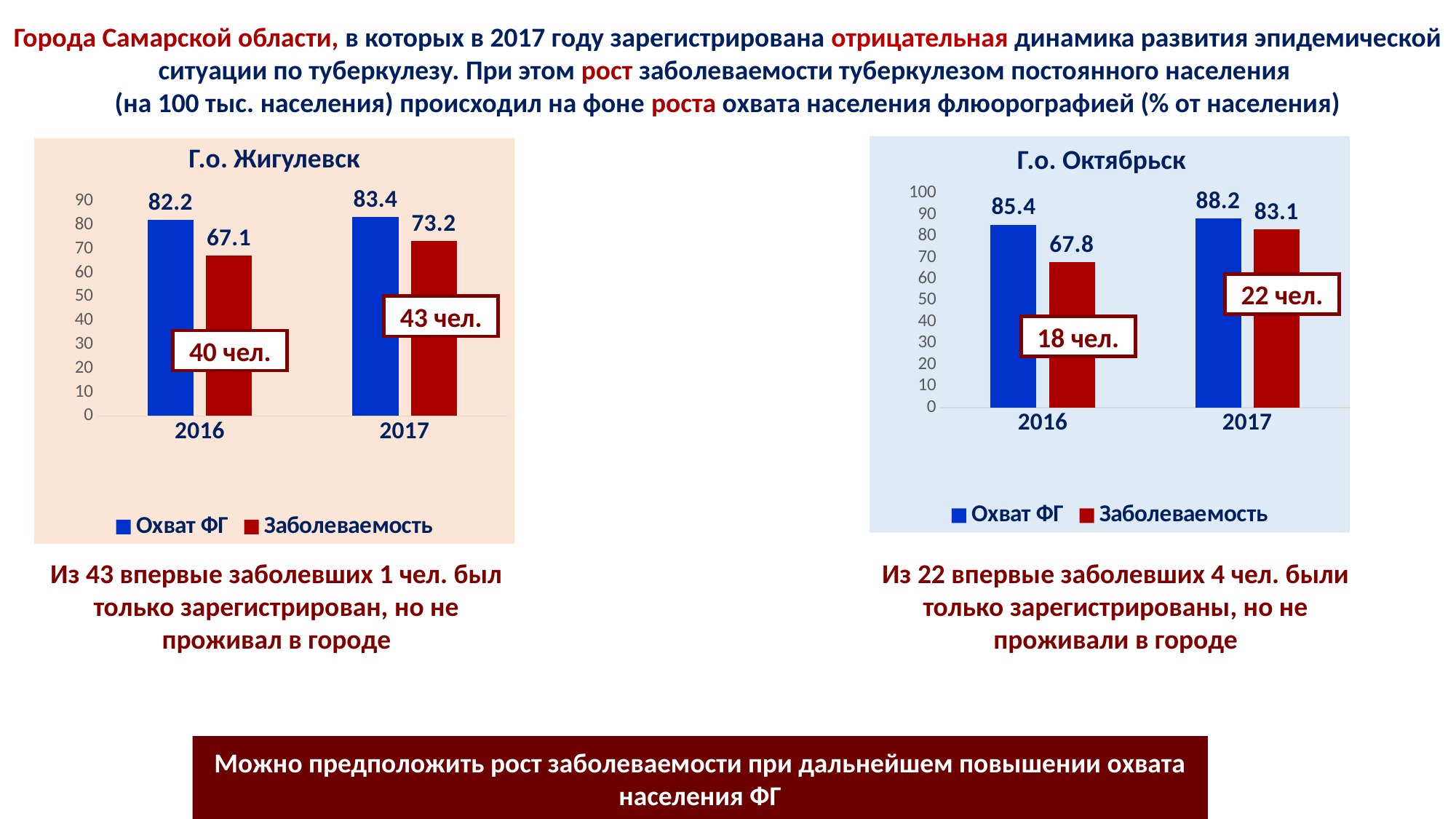
In the chart titled "Г.о. Жигулевск", by how much did Заболеваемость change from 2016 to 2017? 6.1 In the chart titled "Г.о. Жигулевск", what is the value of Охват ФГ for 2016? 82.2 In the chart titled "Г.о. Жигулевск", does Заболеваемость rise or fall from 2016 to 2017? rise In the chart titled "Г.о. Октябрьск", does Охват ФГ rise or fall from 2016 to 2017? rise In the chart titled "Г.о. Октябрьск", what is the value of Заболеваемость for 2016? 67.8 How many series does the legend of the chart titled "Г.о. Жигулевск" list? 2 In the chart titled "Г.о. Октябрьск", what is the value of Охват ФГ for 2017? 88.2 What type of chart is the chart titled "Г.о. Октябрьск"? bar chart In the chart titled "Г.о. Октябрьск", which is larger in 2016: Охват ФГ or Заболеваемость? Охват ФГ In the chart titled "Г.о. Жигулевск", which colour represents Заболеваемость? red In the chart titled "Г.о. Жигулевск", what is the value of Заболеваемость for 2017? 73.2 In the chart titled "Г.о. Октябрьск", what is the difference between Охват ФГ and Заболеваемость in 2017? 5.1